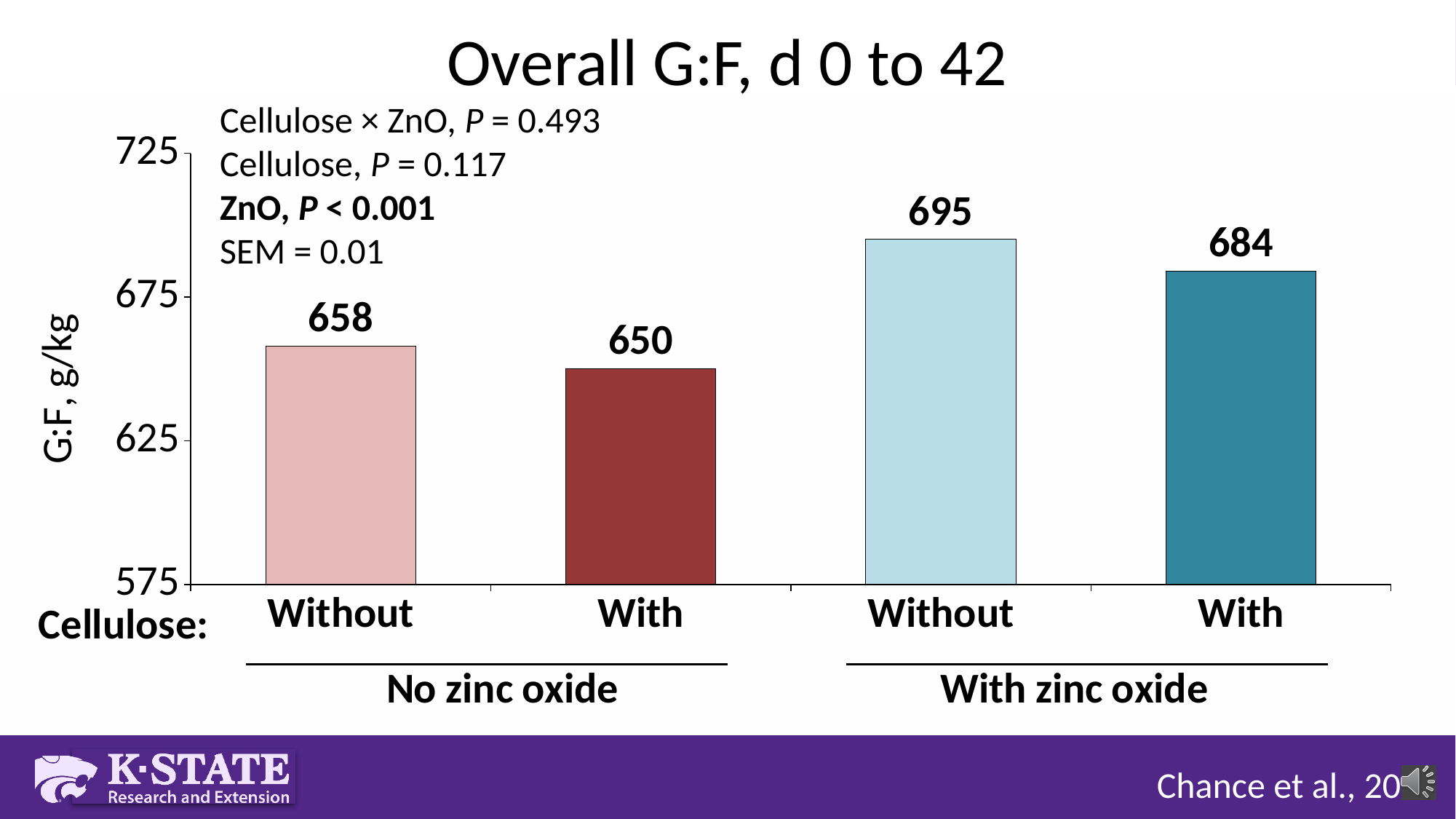
What type of chart is shown on the slide? bar chart What is the difference in G:F between the Without cellulose and With cellulose bars in the With zinc oxide group? 11 Which bar has the lowest G:F value? With cellulose, No zinc oxide What is the difference in G:F between the Without cellulose and With cellulose bars in the No zinc oxide group? 8 What is the G:F value for the With cellulose, With zinc oxide bar? 684 How many bars are plotted in the chart? 4 Which is larger: the G:F for With cellulose with zinc oxide or Without cellulose without zinc oxide? With cellulose with zinc oxide What is the G:F value for the Without cellulose, No zinc oxide bar? 658 What is the title of the chart? Overall G:F, d 0 to 42 Which bar has the highest G:F value? Without cellulose, With zinc oxide What is the G:F value for the Without cellulose, With zinc oxide bar? 695 Is the G:F value for the With cellulose, No zinc oxide bar greater or less than 675? less